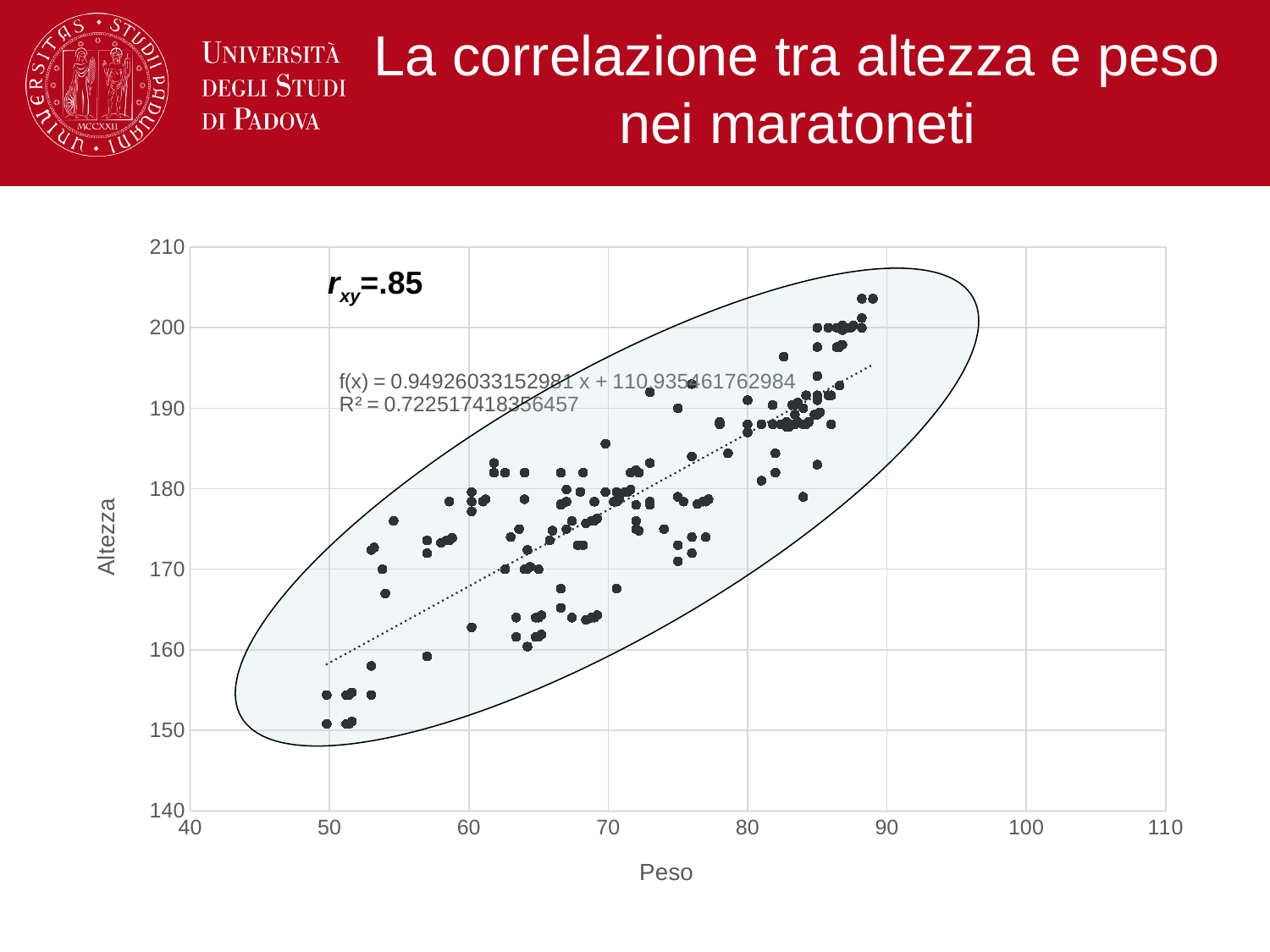
Does Altezza tend to rise or fall as Peso increases along the x axis? Rise What is the label of the y axis of the chart? Altezza Is the Peso of the rightmost point on the chart greater or less than 90? less Is the Altezza of the highest point on the chart greater or less than 200? greater Is the Altezza of the lowest point on the chart greater or less than 160? less What is the intercept of the fitted line f(x) printed on the chart? 110.935461762984 What is the slope of the fitted line f(x) printed on the chart? 0.94926033152981 What is the value of the correlation coefficient r_xy shown on the chart? .85 What is the maximum value shown on the y axis of the chart? 210 What is the R² value printed on the chart? 0.722517418356457 What kind of chart is shown on the slide? Scatter chart What is the label of the x axis of the chart? Peso